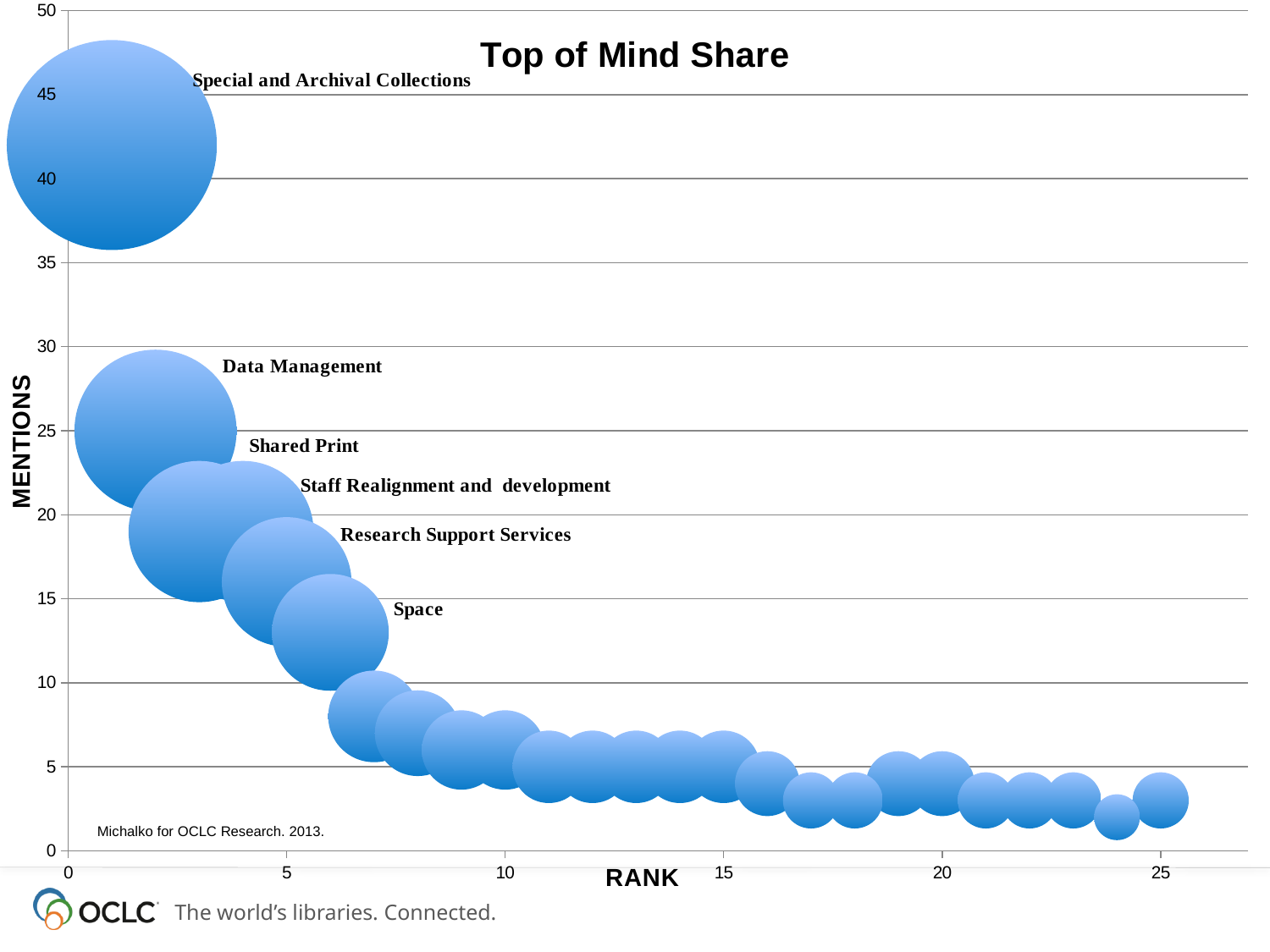
Do the mentions rise or fall as rank increases along the x axis? Fall Is the number of mentions for the bubble at rank 25 greater or less than 5? less What is the title of the chart? Top of Mind Share Which labeled topic has the highest number of mentions? Special and Archival Collections Is the number of mentions for Special and Archival Collections greater or less than 40? greater What kind of chart is shown on the slide? Bubble chart Which has more mentions, Special and Archival Collections or Data Management? Special and Archival Collections How many bubbles on the chart have a text label naming the topic? 6 Which has more mentions, Data Management or Shared Print? Data Management Is the number of mentions for Data Management greater or less than 20? greater What are the labels of the x axis and y axis of the chart? RANK and MENTIONS